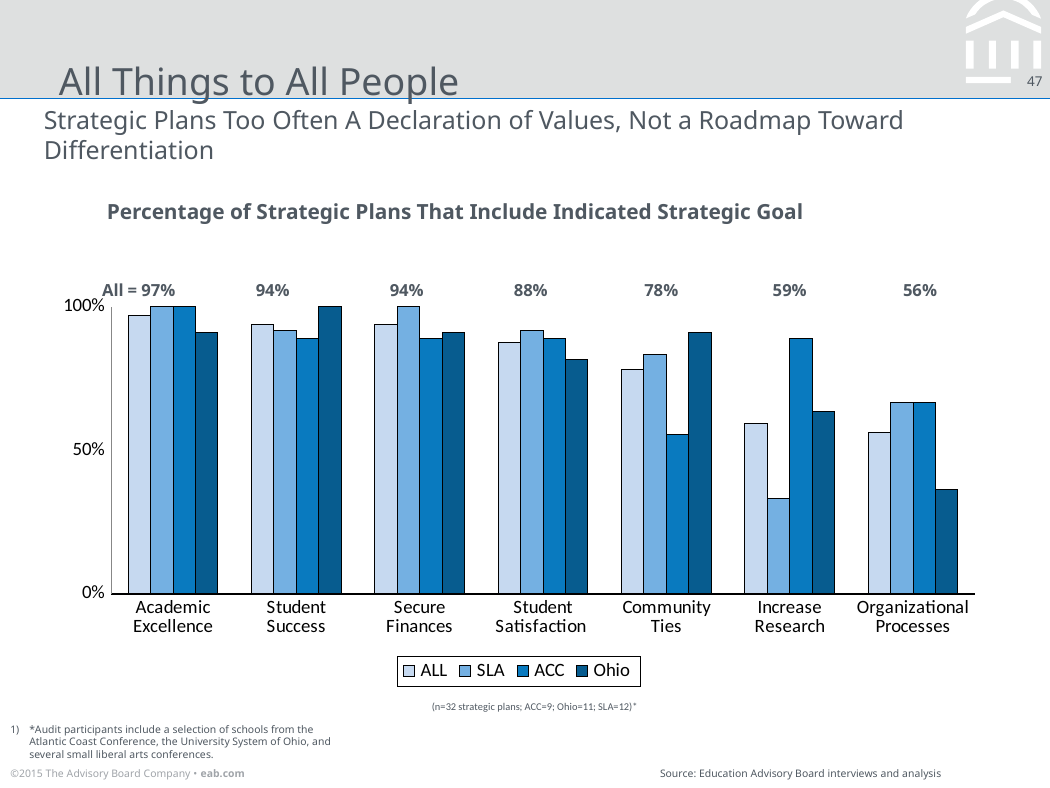
Do the ALL values rise or fall moving from left to right across the categories? fall Is the Ohio value for Organizational Processes greater or less than 50%? less Is the SLA value for Increase Research greater or less than 50%? less How many strategic goals are shown on the x axis? 7 Which has a higher ALL value, Student Satisfaction or Community Ties? Student Satisfaction What is the ALL value for Organizational Processes? 56% How many series does the legend list? 4 What percentage of all strategic plans include Community Ties as a goal? 78% What is the difference in percentage points between the ALL values for Academic Excellence and Organizational Processes? 41 percentage points Which strategic goal has the highest ALL percentage? Academic Excellence Which strategic goal has the lowest ALL percentage? Organizational Processes What is the ALL value for Academic Excellence? 97%